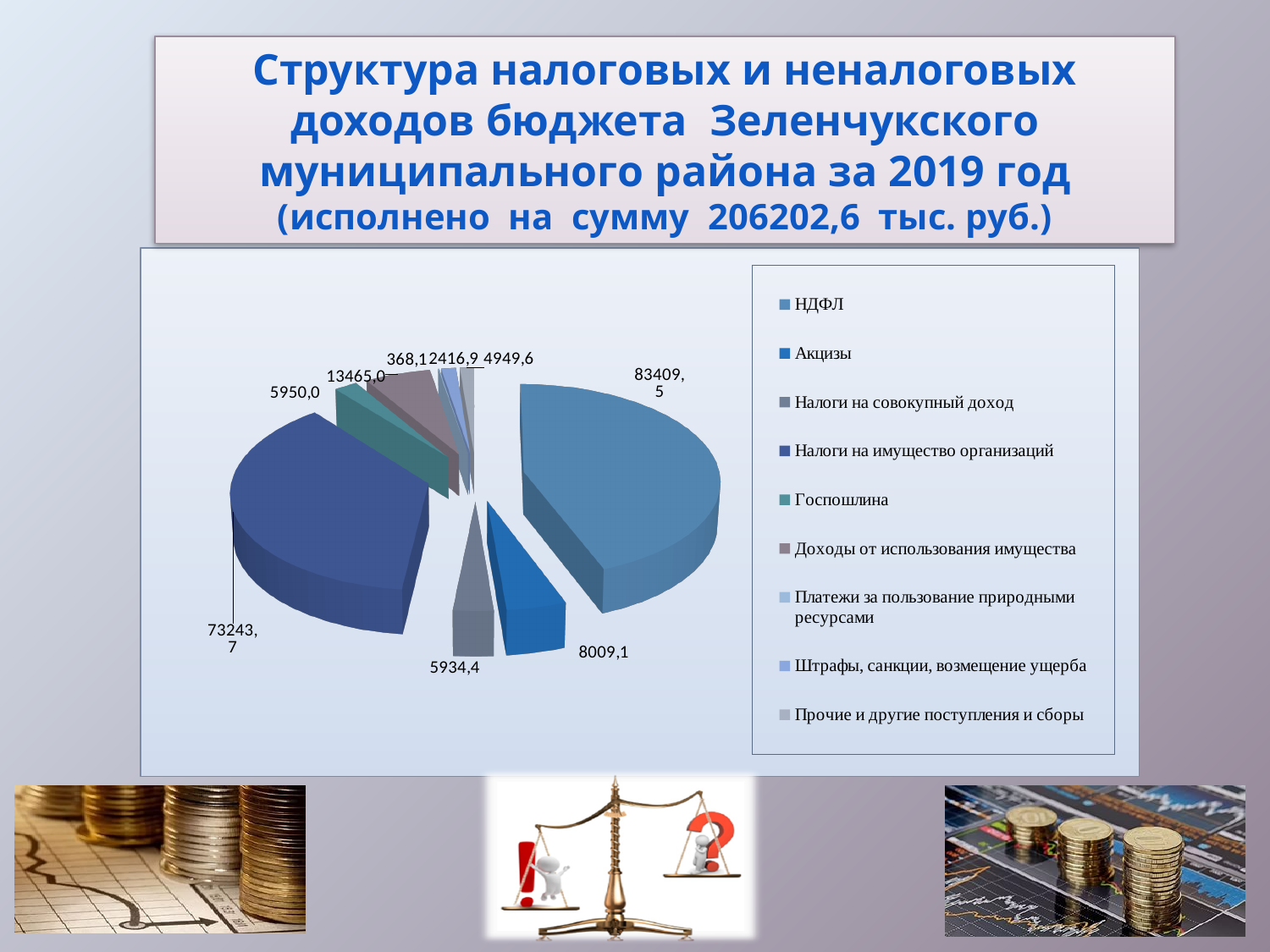
What is the value shown for Доходы от использования имущества? 13465,0 According to the slide title, what total amount was executed (in тыс. руб.)? 206202,6 What is the difference between the values for Доходы от использования имущества and Госпошлина? 7515,0 Which category has the largest slice of the pie? НДФЛ What is the value shown for Налоги на имущество организаций? 73243,7 What kind of chart is shown on the slide? Pie chart How many entries does the chart legend list? 9 Which category has the smallest slice of the pie? Платежи за пользование природными ресурсами Which is larger, the value for Акцизы or the value for Госпошлина? Акцизы How many slices does the pie chart have? 9 What is the difference between the values for НДФЛ and Налоги на имущество организаций? 10165,8 What is the value shown for НДФЛ? 83409,5